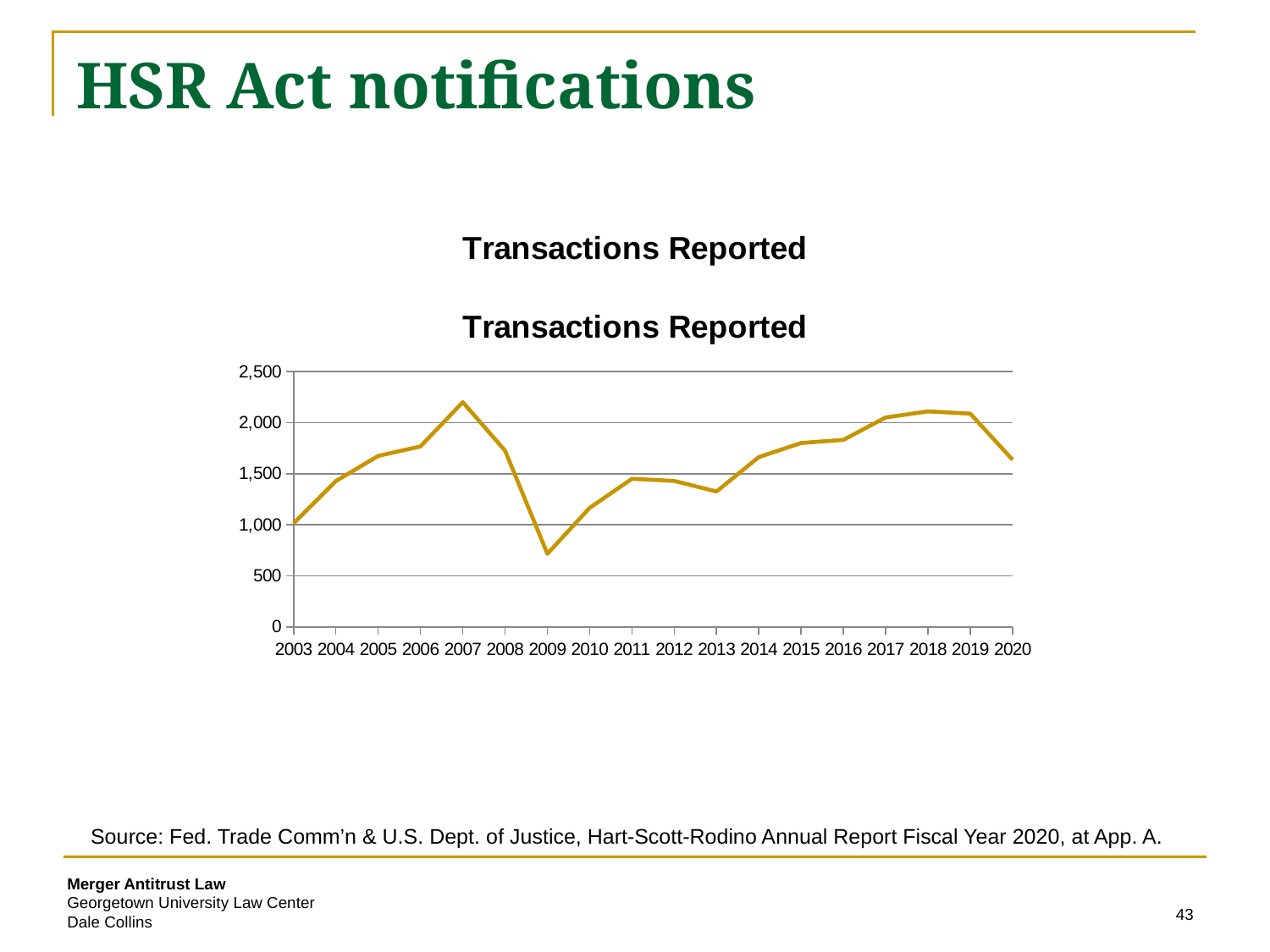
Is the value for 2013 greater or less than 1,500? less Which year has a higher value, 2018 or 2020? 2018 What kind of chart is shown on the slide? line chart Is the value for 2009 greater or less than 1,000? less Which year has a higher value, 2004 or 2010? 2004 Which year has the highest number of transactions reported? 2007 Do the values rise or fall from 2007 to 2009? fall How many years are plotted along the x axis? 18 Is the value for 2020 greater or less than 1,500? greater What is the title of the chart? Transactions Reported Which year has the lowest number of transactions reported? 2009